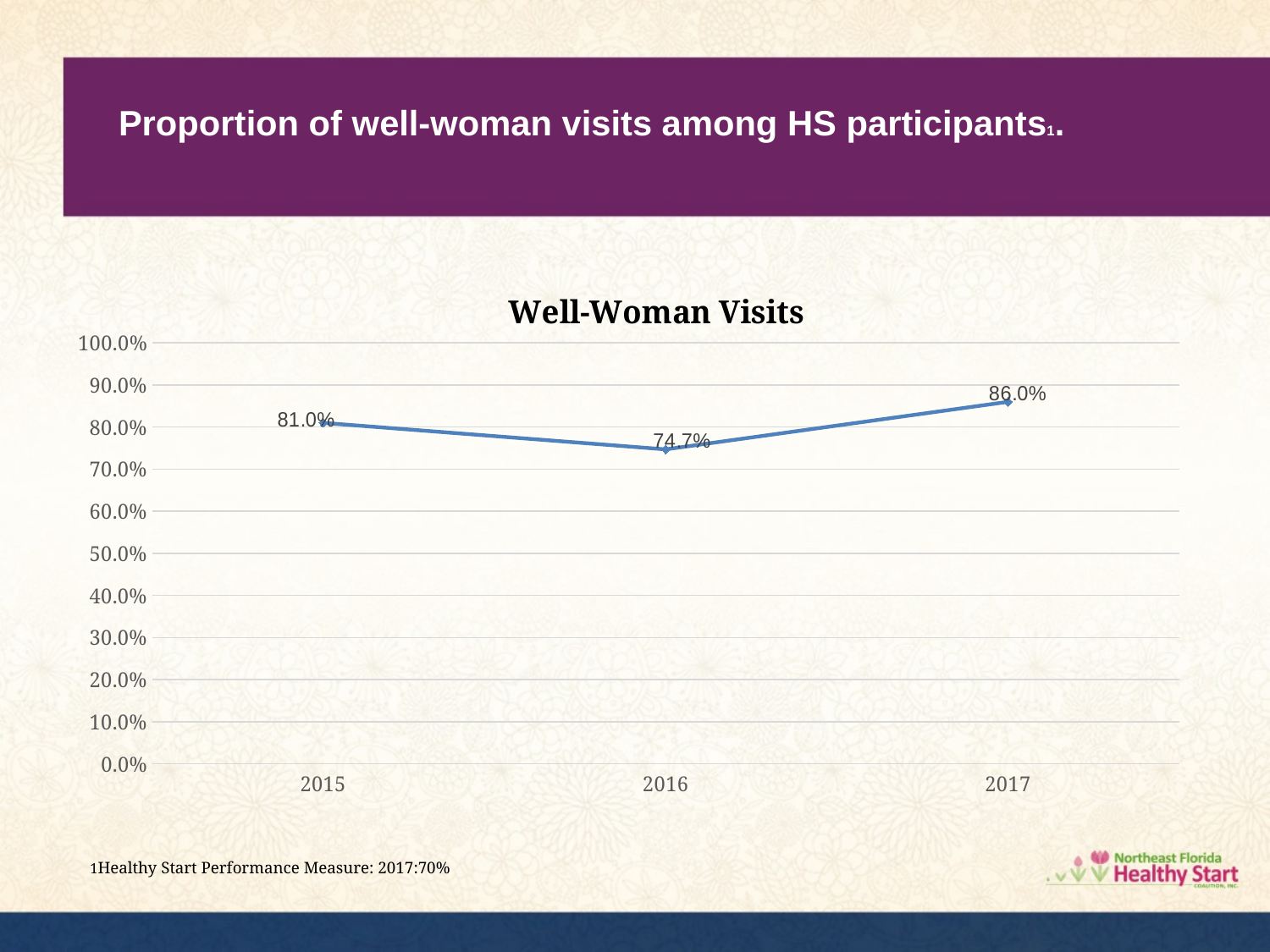
What kind of chart is the Well-Woman Visits chart? line chart What is the difference between the 2015 and 2016 values in the Well-Woman Visits chart? 6.3% Which year has the highest value in the Well-Woman Visits chart? 2017 Is the value for 2016 in the Well-Woman Visits chart greater or less than 80.0%? less Which is larger in the Well-Woman Visits chart, the value for 2015 or the value for 2017? 2017 Which year has the lowest value in the Well-Woman Visits chart? 2016 What is the value for 2017 in the Well-Woman Visits chart? 86.0% How many years are plotted in the Well-Woman Visits chart? 3 What is the value for 2015 in the Well-Woman Visits chart? 81.0% What is the title of the chart on the slide? Well-Woman Visits What is the value for 2016 in the Well-Woman Visits chart? 74.7% What is the difference between the 2017 and 2016 values in the Well-Woman Visits chart? 11.3%